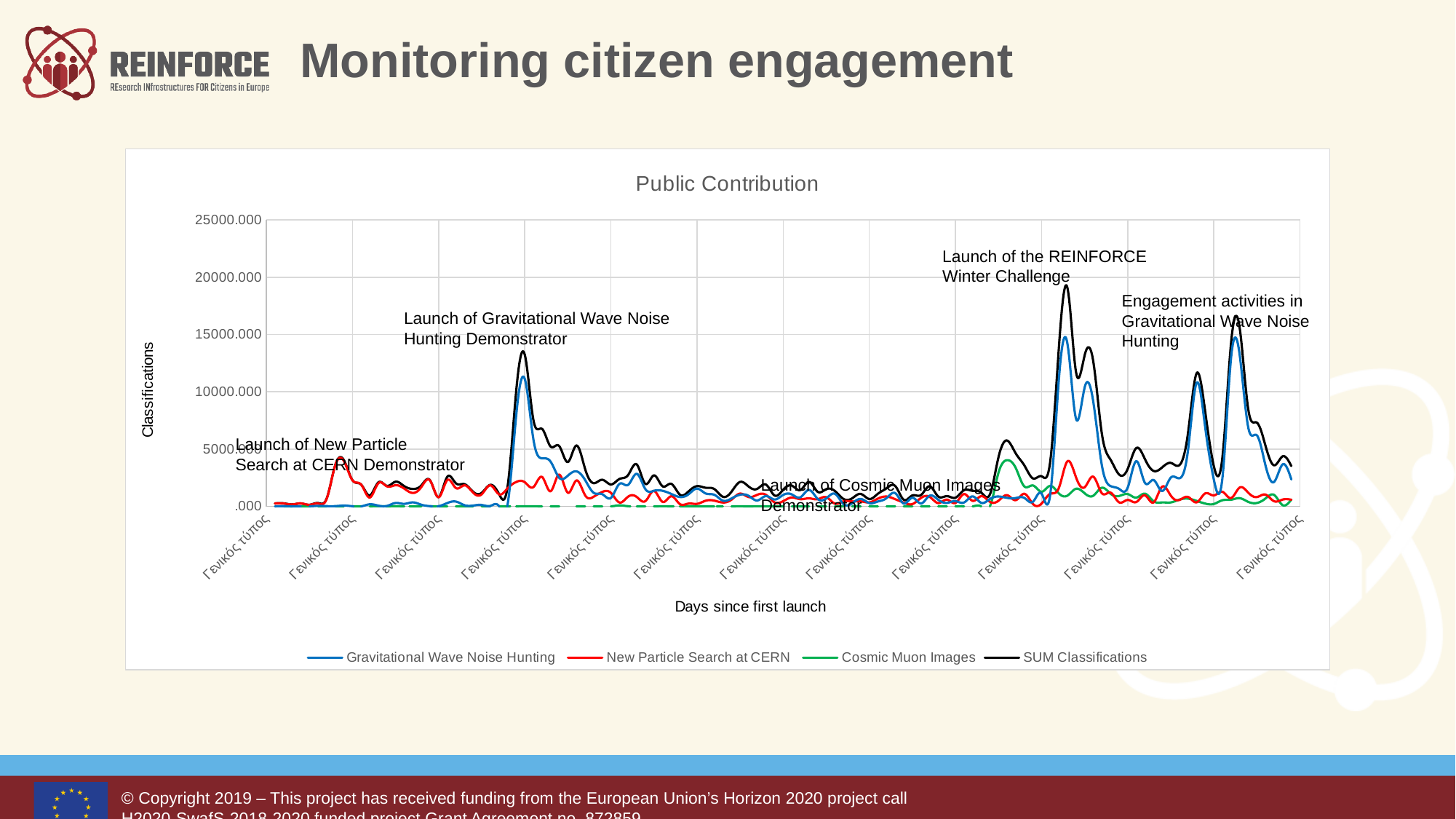
How many series does the chart legend list? 4 Is the highest peak of the Cosmic Muon Images series greater or less than 5000.000? less Which series has a higher peak, Gravitational Wave Noise Hunting or New Particle Search at CERN? Gravitational Wave Noise Hunting Is the highest peak of the New Particle Search at CERN series greater or less than 5000.000? less What kind of chart is shown on the slide? line chart What is the title of the chart? Public Contribution Is the highest peak of the SUM Classifications series greater or less than 20000.000? less Which annotated event is placed next to the highest peak of the chart? Launch of the REINFORCE Winter Challenge Which series reaches the highest peak in the chart? SUM Classifications What is the label of the y axis of the chart? Classifications